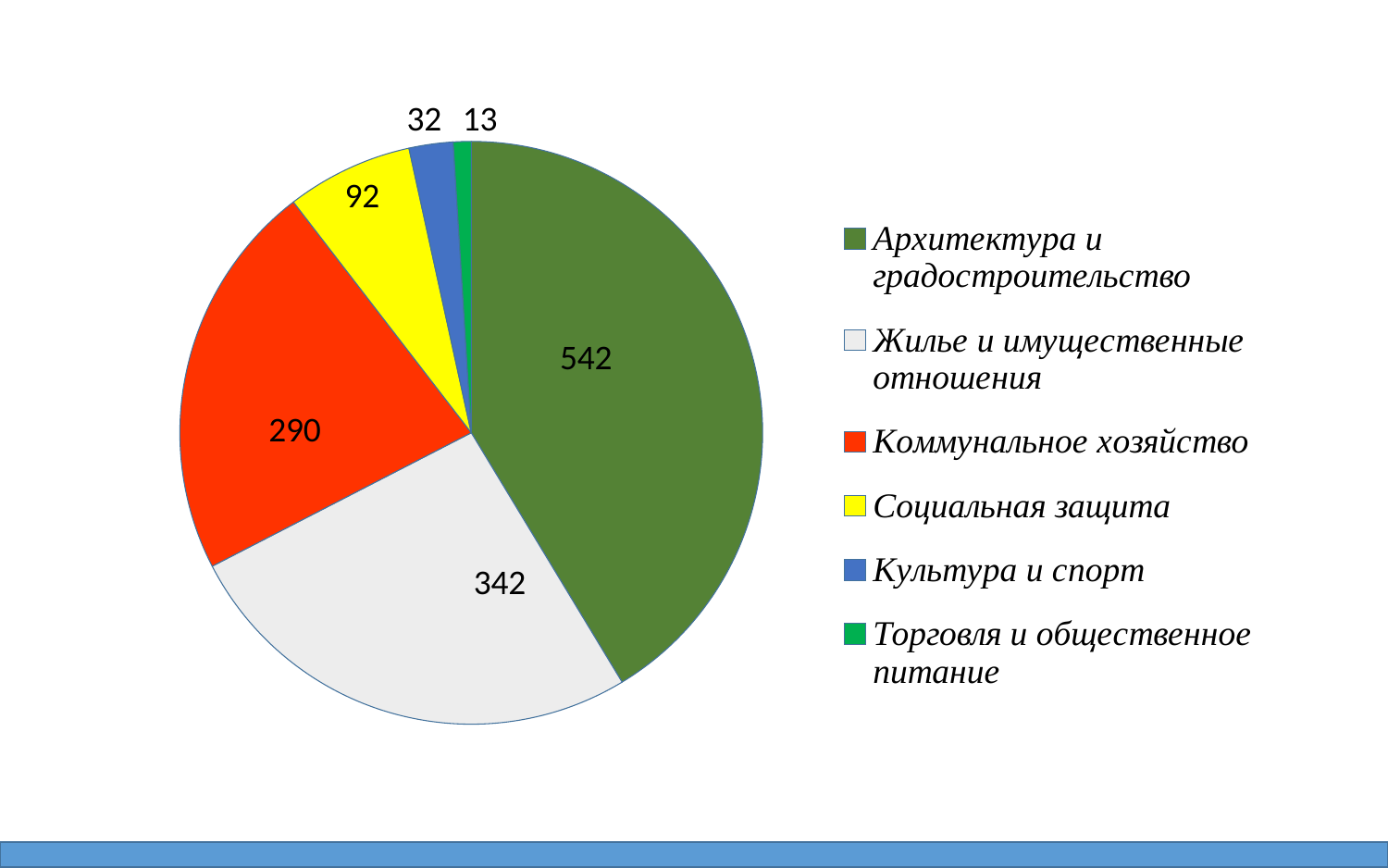
What is the value for Жилье и имущественные отношения? 342 What is the value for Торговля и общественное питание? 13 What is the value for Архитектура и градостроительство? 542 Which category has the largest slice of the pie? Архитектура и градостроительство What is the value for Коммунальное хозяйство? 290 What kind of chart is shown on the slide? Pie chart What is the value for Социальная защита? 92 How many categories does the pie chart have? 6 Which is larger, the value for Коммунальное хозяйство or the value for Социальная защита? Коммунальное хозяйство What is the difference between the values for Архитектура и градостроительство and Жилье и имущественные отношения? 200 What colour is the slice for Культура и спорт? Blue Which category has the smallest slice of the pie? Торговля и общественное питание